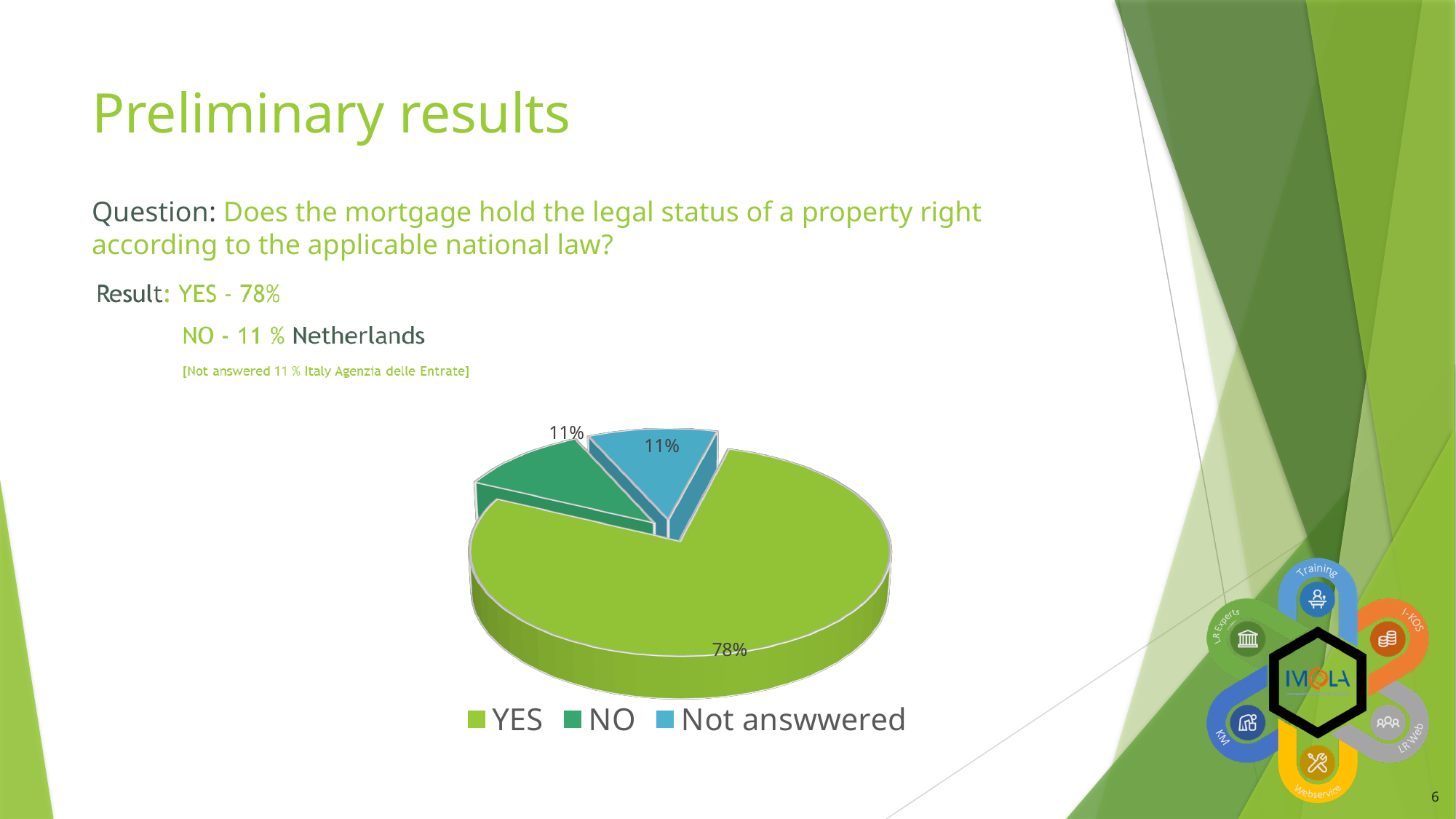
What percentage of the pie chart is labelled NO? 11% How many entries does the legend of the pie chart list? 3 What is the difference in percentage points between the YES slice and the NO slice? 67 Which category has the largest slice of the pie chart? YES Which is larger in the pie chart, the YES slice or the Not answwered slice? YES What colour is the YES slice in the pie chart? green What is the combined share of the NO and Not answwered slices? 22% What percentage of the pie chart is labelled YES? 78% How many slices does the pie chart have? 3 What colour is the Not answwered slice in the pie chart? blue What type of chart is shown on the slide? pie chart What percentage of the pie chart is labelled Not answwered? 11%